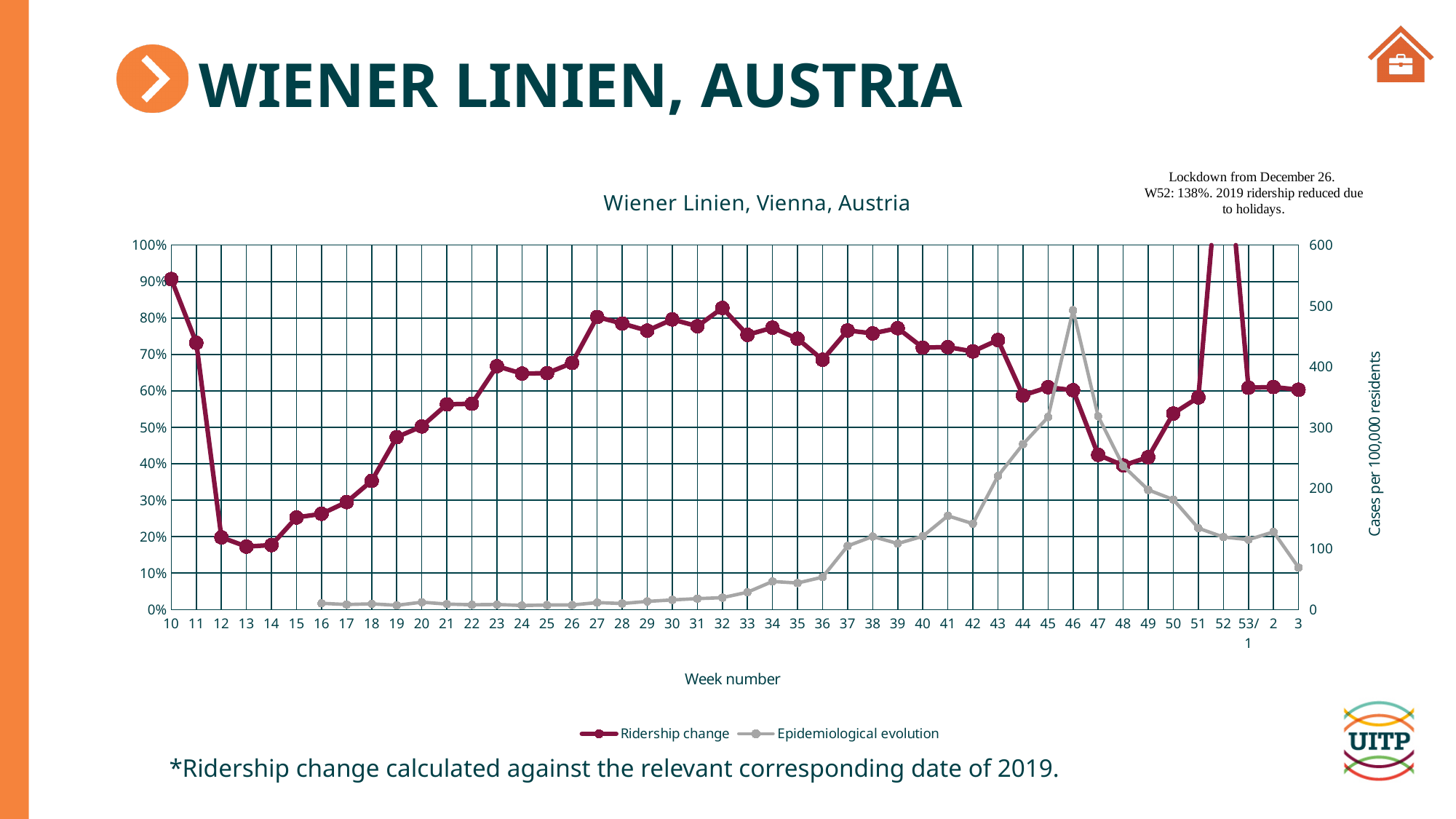
Which week has the larger Ridership change value, week 32 or week 36? Week 32 In which week does the Epidemiological evolution series reach its highest value? 46 What is the title of the chart? Wiener Linien, Vienna, Austria How many series does the chart legend list? 2 Is the Ridership change value for week 13 greater or less than 20%? less Is the Ridership change value for week 32 greater or less than 80%? greater Is the Epidemiological evolution value for week 46 greater or less than 400? greater What is the label of the right-hand vertical axis? Cases per 100,000 residents According to the annotation on the slide, what is the ridership change for week 52? 138% What type of chart is shown on the slide? Line chart Does the Ridership change series rise or fall between week 14 and week 27? Rise